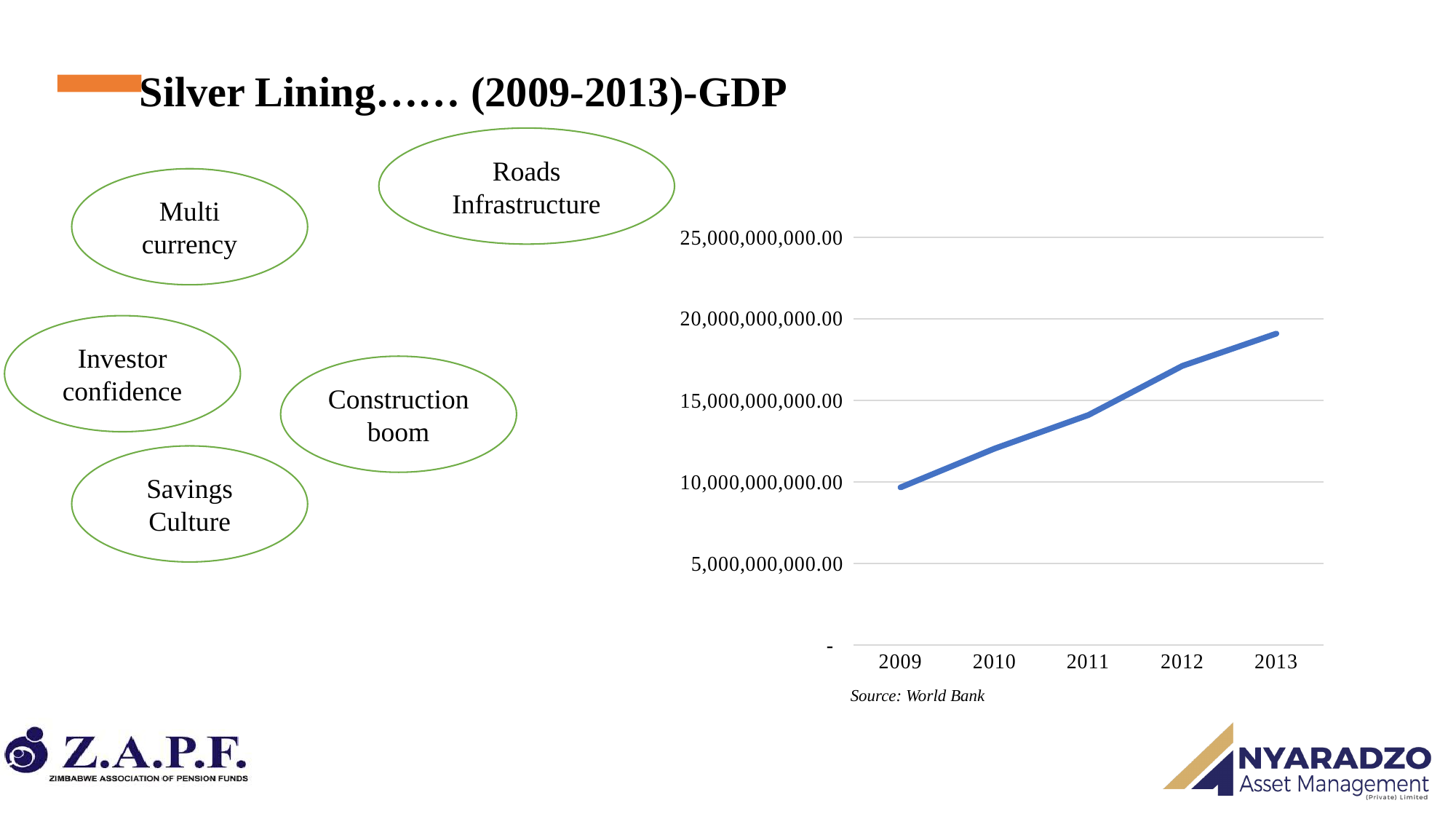
Is the value for 2013 greater or less than 20,000,000,000.00? less Which year has the highest GDP value in the chart? 2013 What kind of chart is shown on the slide? line chart What colour is the line in the chart? blue Is the value for 2012 greater or less than 15,000,000,000.00? greater Which year has the lowest GDP value in the chart? 2009 Is the value for 2010 greater or less than 10,000,000,000.00? greater Do the GDP values rise or fall from 2009 to 2013? rise What source is cited below the chart? World Bank How many years are plotted on the x axis of the chart? 5 Which year has the larger GDP value, 2010 or 2012? 2012